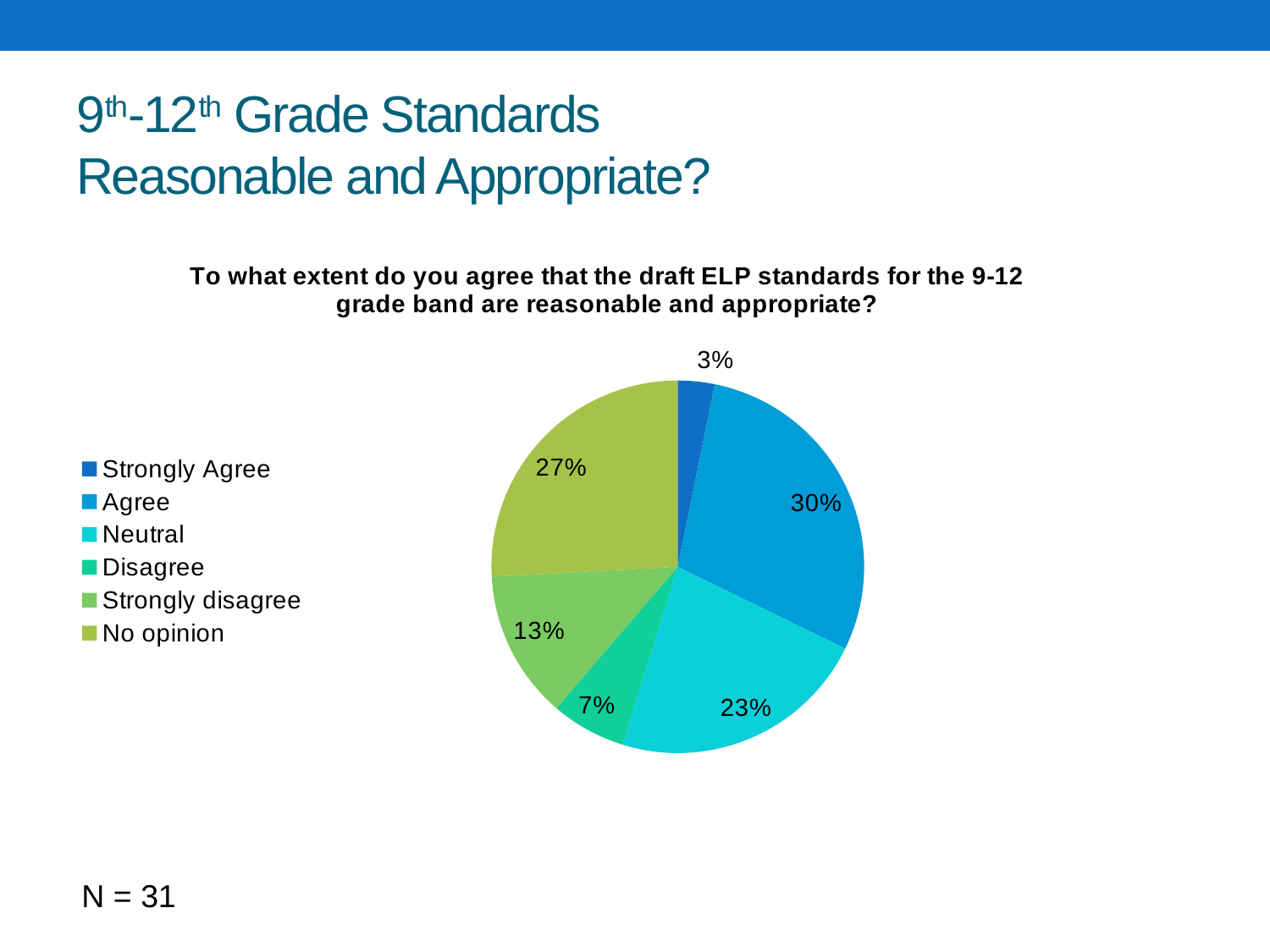
What percentage of respondents chose Agree? 30% What is the difference in percentage points between Agree and Disagree? 23 Which response category has the largest share of the pie? Agree What is the sample size (N) shown on the slide? 31 What percentage of respondents chose Neutral? 23% Which is larger, the share for Neutral or the share for No opinion? No opinion What percentage of respondents chose No opinion? 27% What percentage of respondents chose Strongly disagree? 13% What percentage of respondents chose Strongly Agree? 3% Which response category has the smallest share of the pie? Strongly Agree What kind of chart is shown on the slide? Pie chart How many response categories does the legend list? 6